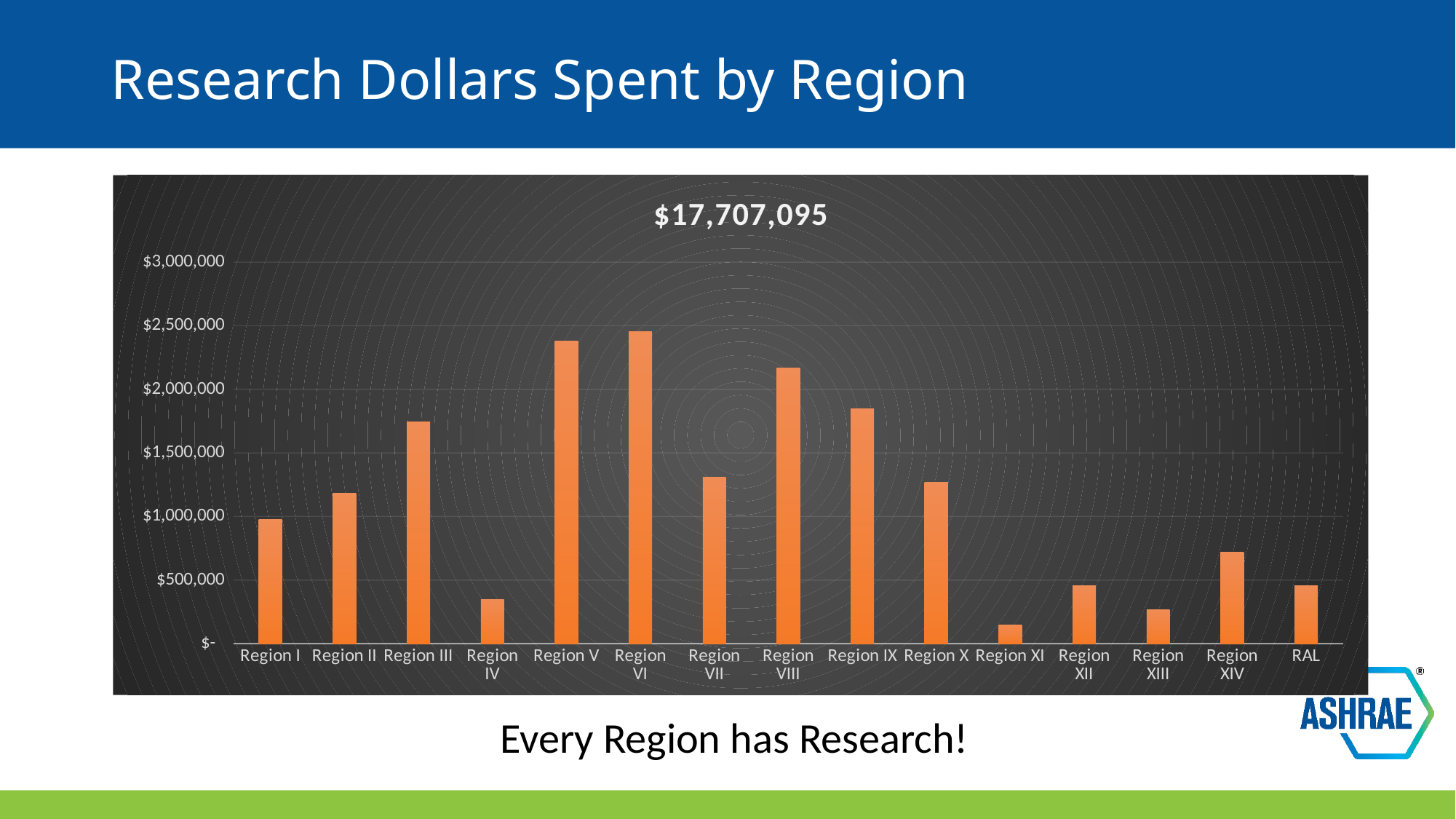
Is the value for Region V greater or less than $2,000,000? greater Is the value for Region III greater or less than $1,500,000? greater Which is larger, the value for Region II or the value for Region XIII? Region II Which region has the lowest research dollars spent? Region XI Is the value for Region IV greater or less than $500,000? less How many categories are plotted along the x axis of the chart? 15 What colour are the bars in the chart? orange Which is larger, the value for Region III or the value for Region IX? Region IX What total figure is shown as the chart's title above the bars? $17,707,095 What kind of chart is shown on the slide? bar chart